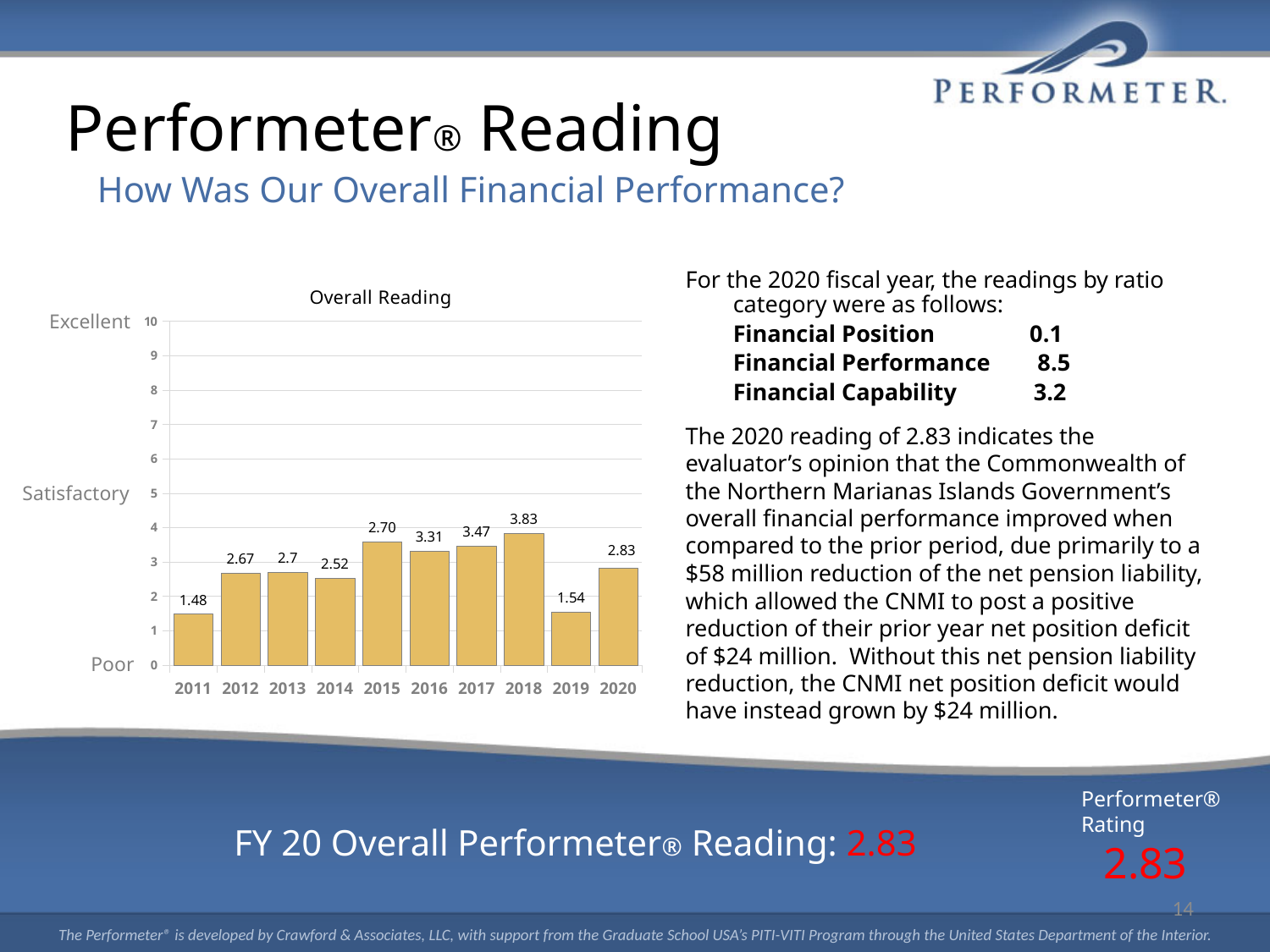
What kind of chart is the Overall Reading chart? bar chart How many years are shown on the x axis of the Overall Reading chart? 10 What is the Overall Reading value for 2011? 1.48 Which year has a higher Overall Reading, 2016 or 2017? 2017 Did the Overall Reading rise or fall from 2019 to 2020? rise Which year has the highest Overall Reading? 2018 What is the difference between the Overall Reading for 2018 and 2019? 2.29 Which year has the lowest Overall Reading? 2011 What is the Overall Reading value for 2020? 2.83 Is the Overall Reading for 2015 greater or less than 2? greater What is the Overall Reading value for 2019? 1.54 What label appears next to the value 5 on the y axis of the Overall Reading chart? Satisfactory